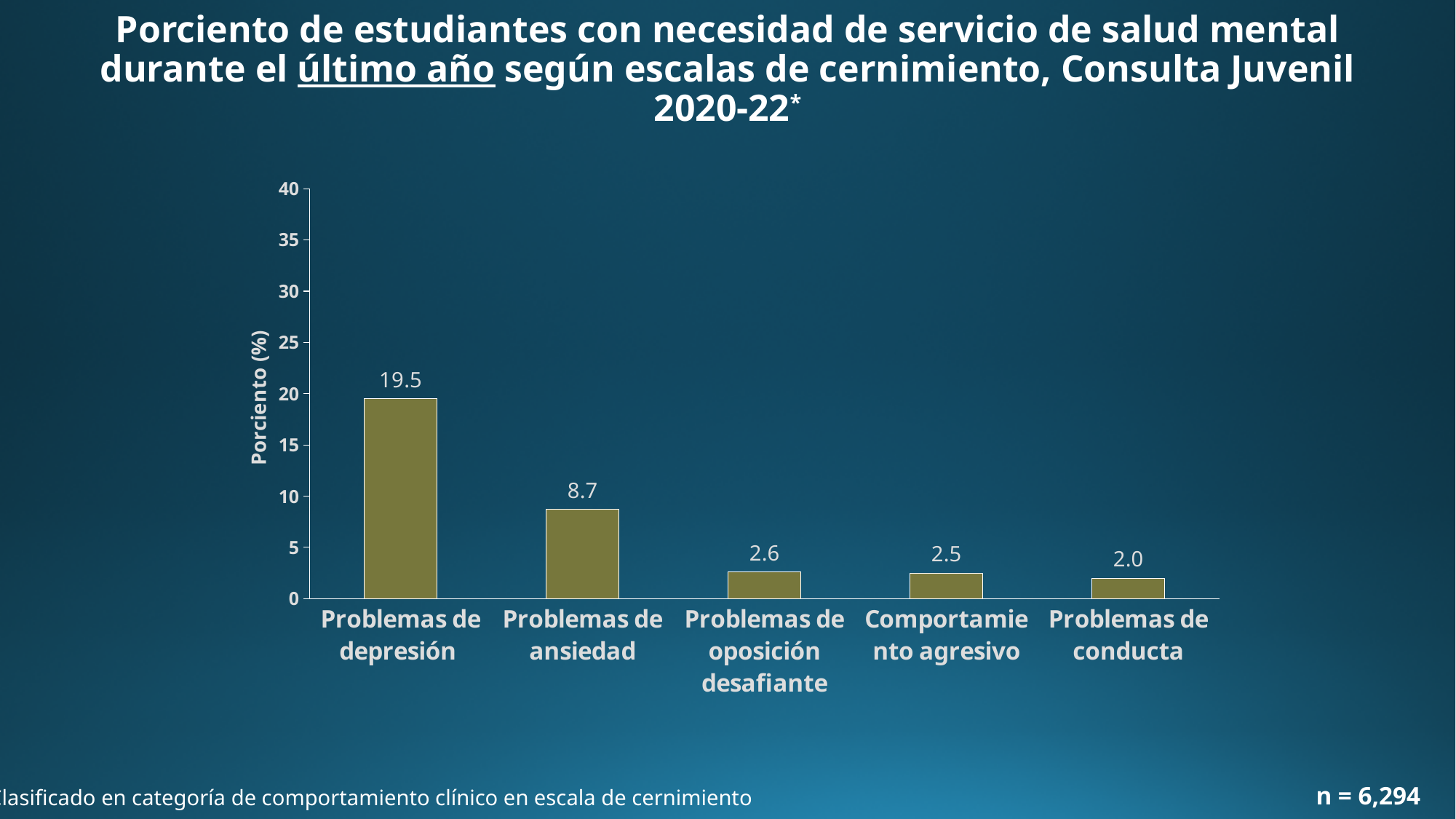
What is the value for Problemas de ansiedad? 8.7 Is the value for Problemas de depresión greater or less than 15? greater What is the difference between the values for Problemas de depresión and Problemas de ansiedad? 10.8 How many categories are shown on the chart? 5 Which category has the highest value? Problemas de depresión What is the value for Problemas de depresión? 19.5 What is the value for Problemas de oposición desafiante? 2.6 Which category has the lowest value? Problemas de conducta What kind of chart is shown on the slide? bar chart Which is larger, the value for Problemas de ansiedad or the value for Comportamiento agresivo? Problemas de ansiedad What is the value for Problemas de conducta? 2.0 What is the label of the vertical axis? Porciento (%)